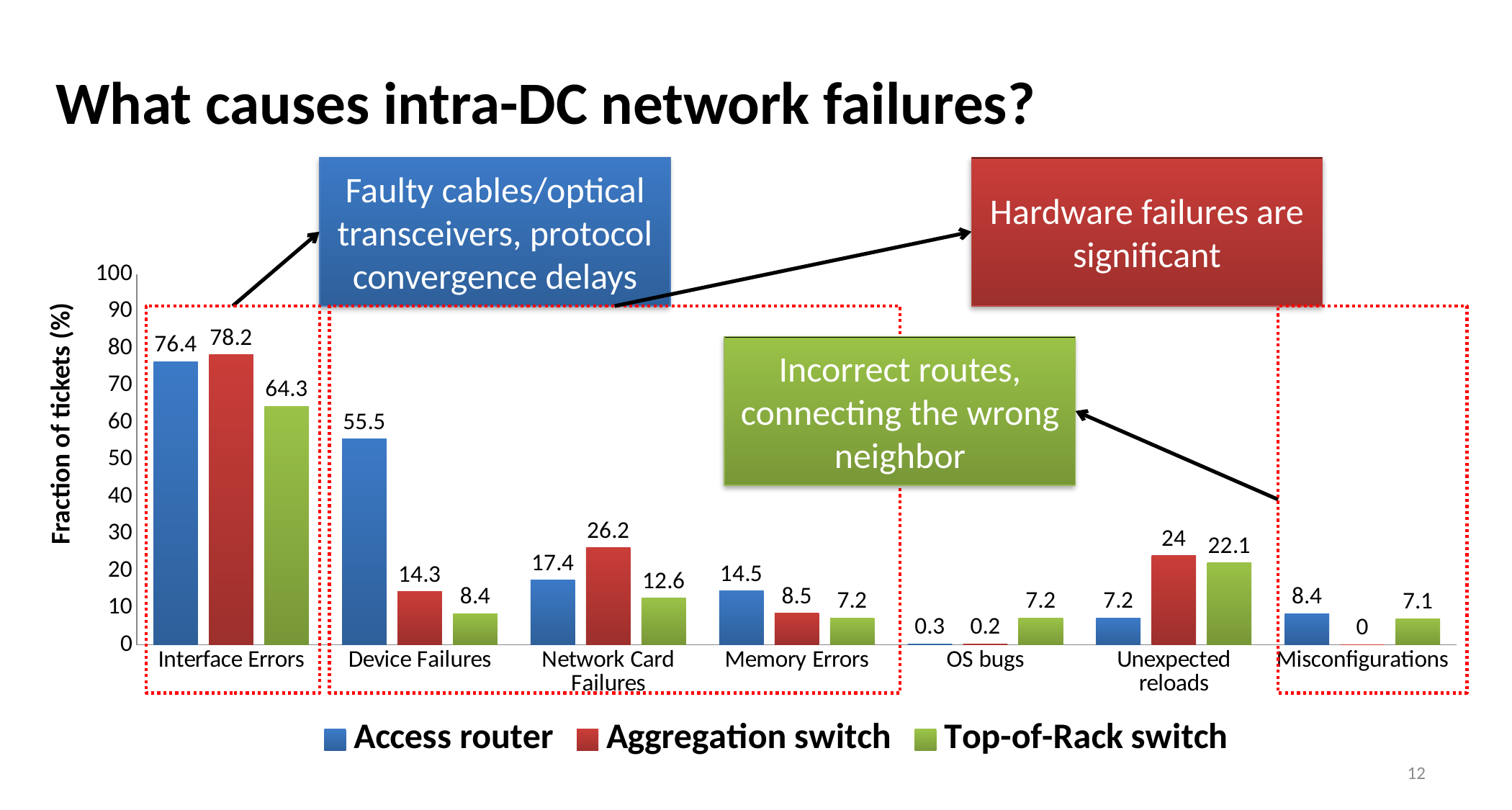
What is the label of the y axis? Fraction of tickets (%) What kind of chart is shown on the slide? Bar chart What is the difference between the Access router and Aggregation switch values under Device Failures? 41.2 What is the value for Aggregation switch under Network Card Failures? 26.2 How many categories are shown on the x axis? 7 Which category has the highest Access router value? Interface Errors What is the value for Access router under Interface Errors? 76.4 How many series does the legend list? 3 Which category has the lowest Aggregation switch value? Misconfigurations What is the value for Top-of-Rack switch under Unexpected reloads? 22.1 What is the value for Aggregation switch under Misconfigurations? 0 Under Memory Errors, which is larger: the Access router value or the Top-of-Rack switch value? Access router